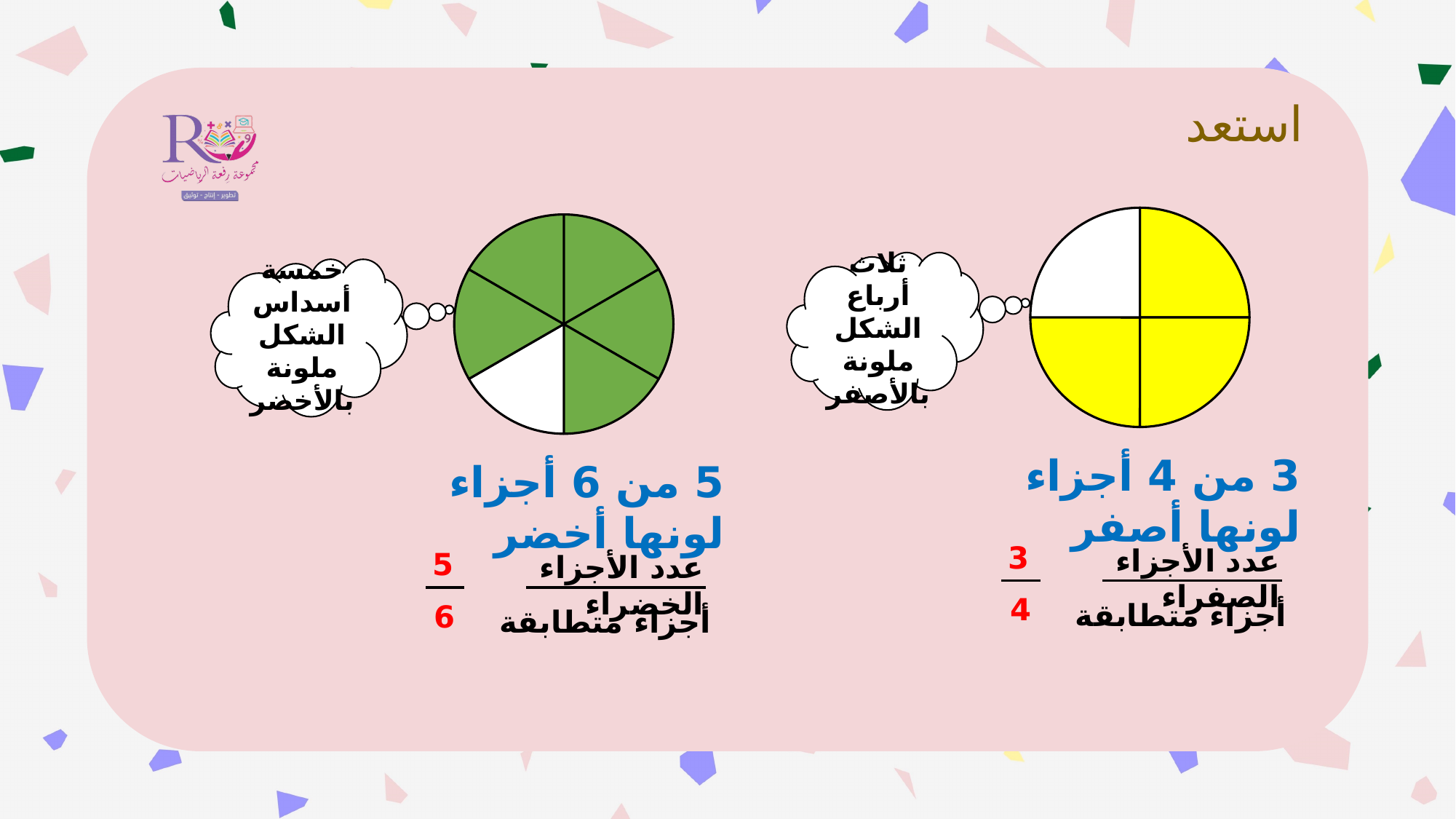
What colour is the shaded portion of the circle on the left? green What colour is the shaded portion of the circle on the right? yellow In the yellow circle on the right, how many equal parts is the circle divided into? 4 In the yellow circle on the right, how many parts are left white (unshaded)? 1 In the green circle on the left, how many parts are coloured green? 5 In the green circle on the left, how many parts are left white (unshaded)? 1 What fraction of the left circle is shaded green, as written in red on the slide? 5/6 In the yellow circle on the right, how many parts are coloured yellow? 3 In the green circle on the left, how many equal parts is the circle divided into? 6 What fraction of the right circle is shaded yellow, as written in red on the slide? 3/4 Which circle is divided into more parts, the green one on the left or the yellow one on the right? the green one on the left